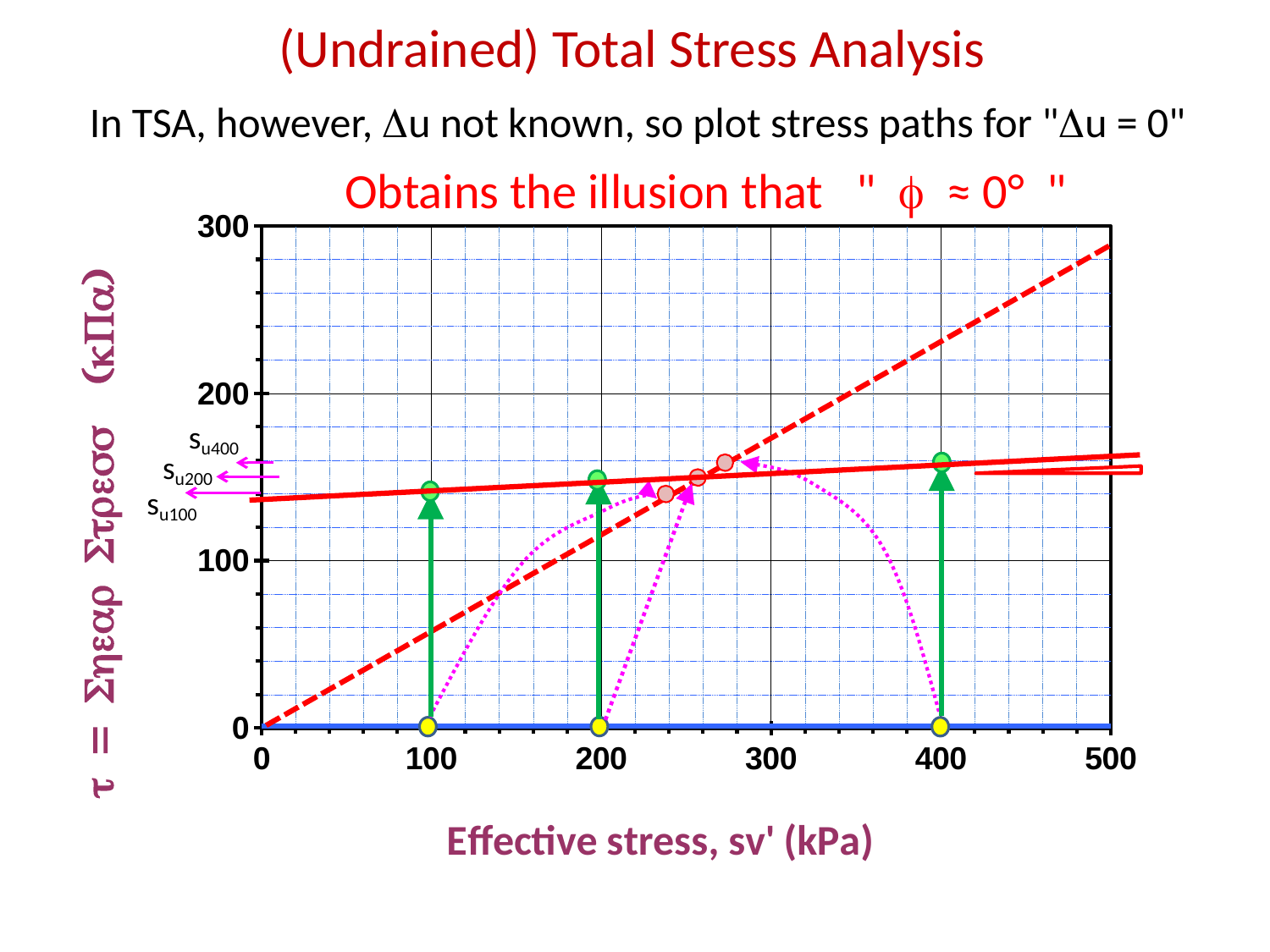
Is the shear stress of the green point at an effective stress of 200 greater or less than 200? less What is the highest value shown on the x axis of the chart? 500 Is the shear stress of the green point at an effective stress of 400 greater or less than 200? less Does the red dashed line rise or fall as effective stress increases? rises Which of the three green points has the highest shear stress: the one at effective stress 100, 200 or 400? 400 What is the shear stress value of the yellow point at an effective stress of 200? 0 How many yellow points are plotted on the horizontal axis at zero shear stress? 3 At what effective stress values are the three yellow points plotted? 100, 200 and 400 Which of the three green points has the lowest shear stress: the one at effective stress 100, 200 or 400? 100 What kind of chart is shown on the slide? line chart What is the label of the x axis of the chart? Effective stress, sv' (kPa) Is the shear stress of the green point at an effective stress of 100 greater or less than 100? greater